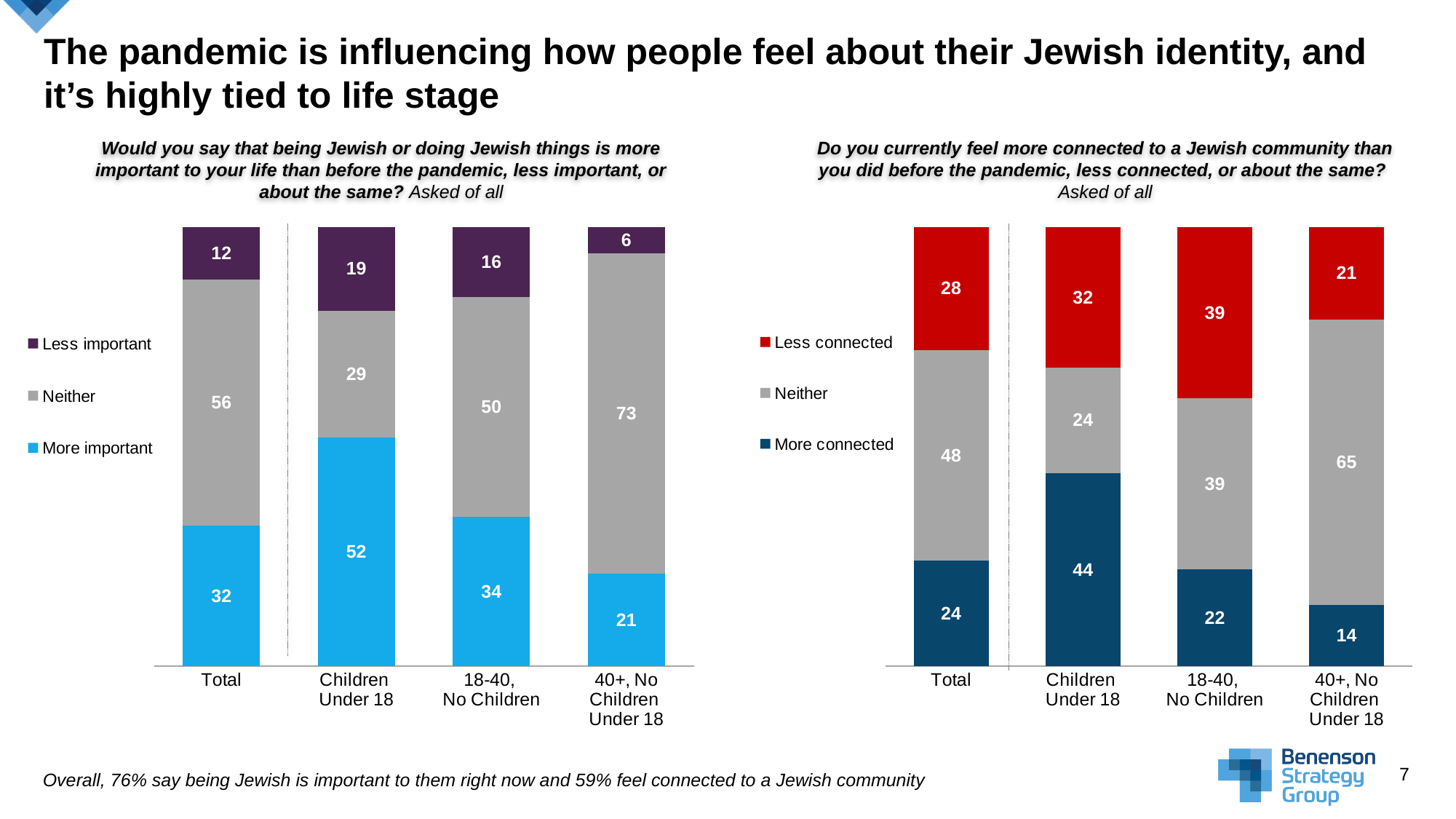
In the left chart, what is the total of the stacked bar for Total? 100 In the right chart, what is the difference between the 'Neither' values for 40+, No Children Under 18 and Children Under 18? 41 What colour represents 'Less connected' in the right chart? Red What kind of chart is the right chart? Stacked bar chart In the right chart, which category has the lowest 'More connected' value? 40+, No Children Under 18 In the left chart, which category has the highest 'Neither' value? 40+, No Children Under 18 In the left chart (importance of being Jewish), what is the 'More important' value for Children Under 18? 52 In the right chart, which is larger: the 'More connected' value for Children Under 18 or for 18-40, No Children? Children Under 18 In the right chart (connection to a Jewish community), what is the 'Less connected' value for 18-40, No Children? 39 In the left chart, what is the difference between the 'More important' values for Children Under 18 and Total? 20 How many categories are shown on the x axis of the left chart? 4 How many series does the legend of the right chart list? 3